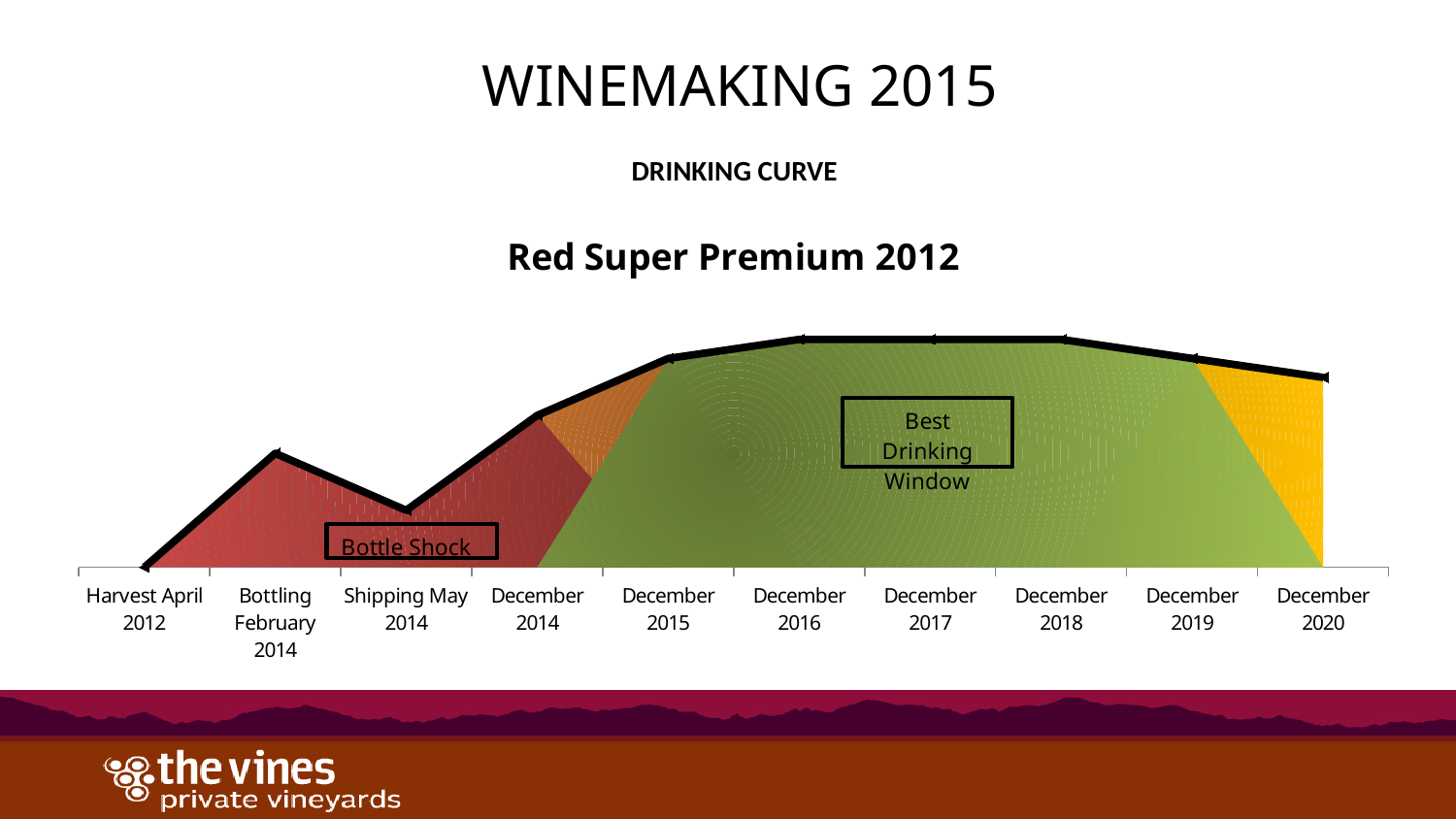
Does the drinking curve rise or fall between Bottling February 2014 and Shipping May 2014? Fall Which is higher on the drinking curve, December 2020 or Harvest April 2012? December 2020 Which is higher on the drinking curve, December 2017 or December 2020? December 2017 Does the drinking curve rise or fall between Shipping May 2014 and December 2015? Rise Which is higher on the drinking curve, Bottling February 2014 or Shipping May 2014? Bottling February 2014 How many categories are shown along the x axis of the drinking curve chart? 10 Does the drinking curve rise or fall between December 2018 and December 2020? Fall What label is shown in the box over the dip between Bottling February 2014 and Shipping May 2014? Bottle Shock Which category on the x axis has the lowest value on the drinking curve? Harvest April 2012 Which wine is the drinking curve chart about, according to the chart title? Red Super Premium 2012 What kind of chart is shown on the slide? Area chart